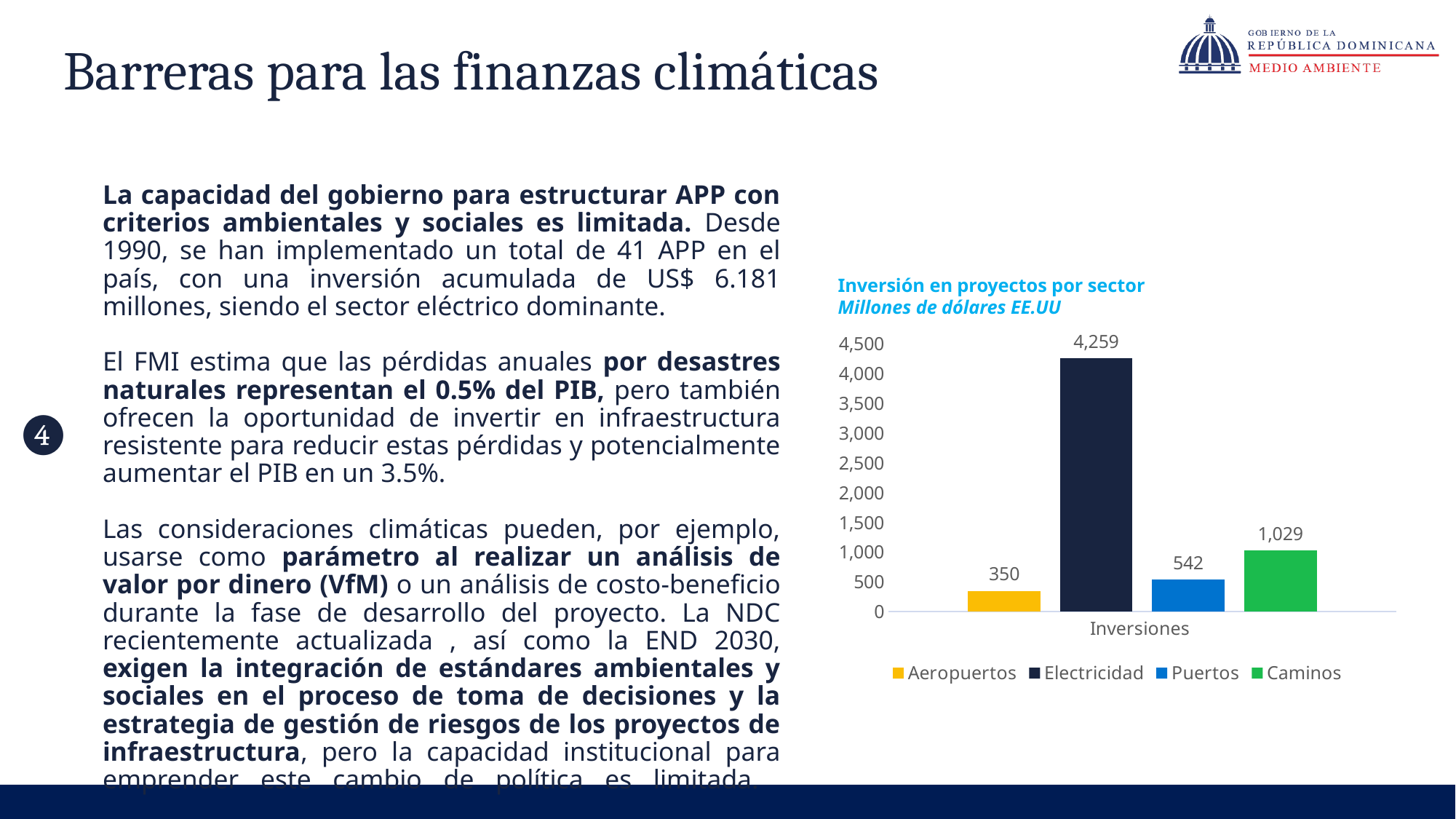
What is the difference between the values for Puertos and Aeropuertos? 192 What is the title of the chart? Inversión en proyectos por sector Which sector has the lowest investment in the chart? Aeropuertos What kind of chart is shown on the slide? Bar chart What is the difference between the values for Electricidad and Caminos? 3,230 What is the value for Caminos in the chart? 1,029 How many series does the legend list? 4 What is the value for Electricidad in the chart? 4,259 Which is larger, the value for Caminos or the value for Puertos? Caminos Which sector has the highest investment in the chart? Electricidad What is the value for Puertos in the chart? 542 What is the value for Aeropuertos in the chart? 350